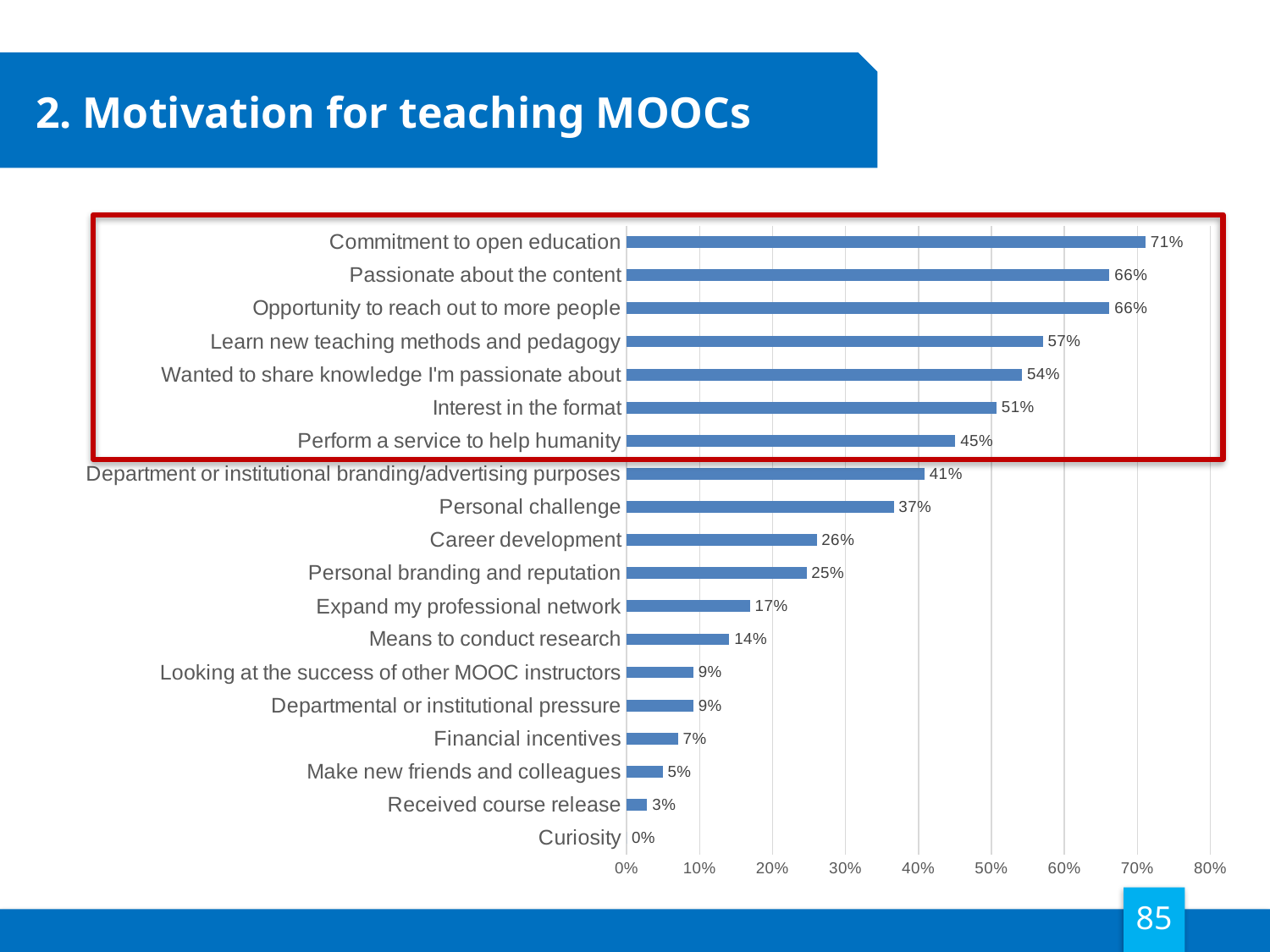
How many categories are shown in the chart? 19 What is the value for "Commitment to open education"? 71% What is the difference between "Commitment to open education" and "Perform a service to help humanity"? 26% What is the value for "Personal challenge"? 37% Which category has the lowest value? Curiosity Which category has the highest value? Commitment to open education Which is larger: "Career development" or "Expand my professional network"? Career development Is the value for "Interest in the format" greater or less than 40%? greater What kind of chart is shown on the slide? Bar chart What is the value for "Learn new teaching methods and pedagogy"? 57% What is the value for "Financial incentives"? 7% What is the title of the slide? 2. Motivation for teaching MOOCs